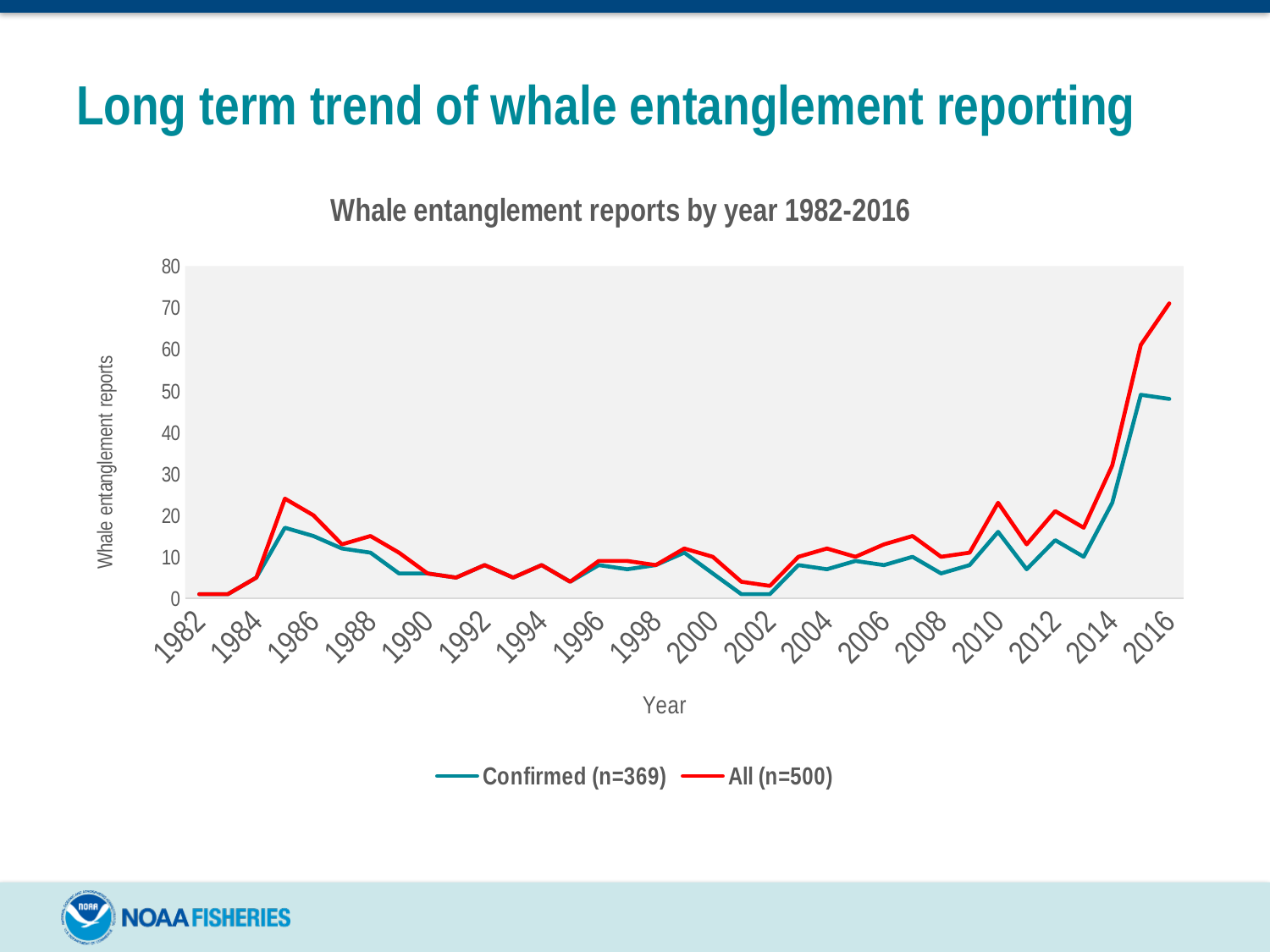
What kind of chart is shown on the slide? line chart How many series does the legend list? 2 Is the value for Confirmed (n=369) in 2001 greater or less than 10? less Is the value for All (n=500) in 2016 greater or less than 60? greater Is the value for Confirmed (n=369) in 2016 greater or less than 40? greater What is the title of the chart? Whale entanglement reports by year 1982-2016 In which year does the Confirmed (n=369) series reach its highest value? 2015 Which series has the larger value in 2016, Confirmed (n=369) or All (n=500)? All (n=500) In which year does the All (n=500) series reach its highest value? 2016 What are the two series named in the legend? Confirmed (n=369) and All (n=500) Do the values for All (n=500) rise or fall from 2013 to 2016? rise